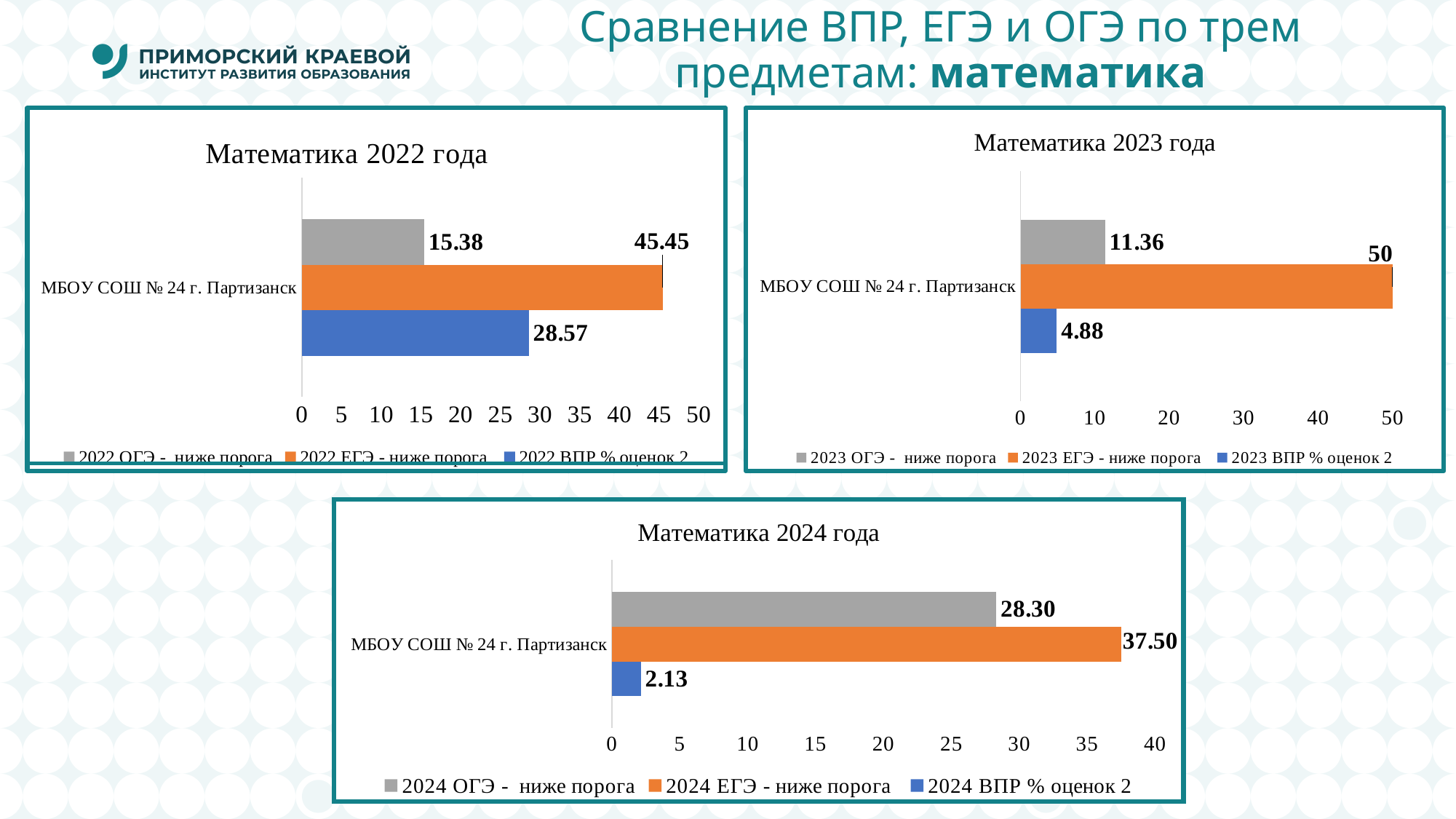
In the chart titled "Математика 2022 года", what is the difference between the ЕГЭ value and the ОГЭ value? 30.07 In the chart titled "Математика 2023 года", what is the difference between the ОГЭ value and the ВПР value? 6.48 In the chart titled "Математика 2023 года", which series has the highest value? 2023 ЕГЭ - ниже порога In the chart titled "Математика 2024 года", what is the value for "2024 ВПР % оценок 2"? 2.13 In the chart titled "Математика 2024 года", how many series does the legend list? 3 In the chart titled "Математика 2022 года", what is the value for "2022 ЕГЭ - ниже порога"? 45.45 In the chart titled "Математика 2022 года", what is the value for "2022 ВПР % оценок 2"? 28.57 In the chart titled "Математика 2022 года", what colour is the bar for "2022 ЕГЭ - ниже порога"? Orange In the chart titled "Математика 2023 года", what is the value for "2023 ОГЭ - ниже порога"? 11.36 In the chart titled "Математика 2024 года", which is larger: the ОГЭ value or the ЕГЭ value? 2024 ЕГЭ - ниже порога In the chart titled "Математика 2022 года", which series has the lowest value? 2022 ОГЭ - ниже порога What kind of chart is the chart titled "Математика 2024 года"? Bar chart